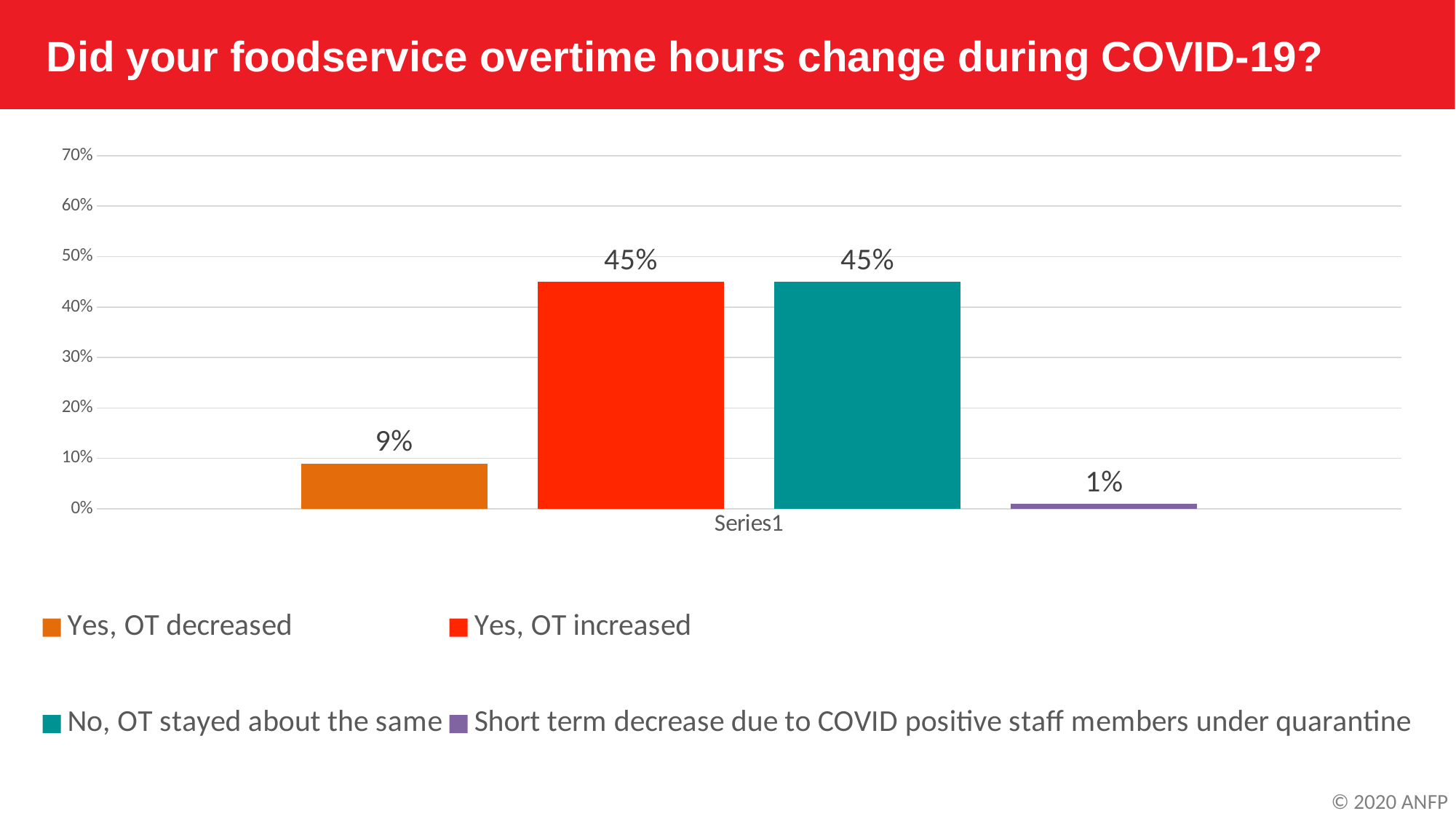
What colour is the bar for 'No, OT stayed about the same'? Teal Which is larger: the percentage for 'Yes, OT decreased' or for 'Short term decrease due to COVID positive staff members under quarantine'? Yes, OT decreased What percentage of respondents said their OT increased? 45% What percentage of respondents reported a short term decrease due to COVID positive staff members under quarantine? 1% What percentage of respondents said their OT decreased? 9% What kind of chart is shown on the slide? Bar chart What is the difference between the percentage for 'Yes, OT increased' and 'Yes, OT decreased'? 36% How many series does the legend list? 4 Is the value for 'Yes, OT increased' greater or less than 40%? greater Which response has the lowest percentage? Short term decrease due to COVID positive staff members under quarantine What is the title of the chart? Did your foodservice overtime hours change during COVID-19? What percentage of respondents said OT stayed about the same? 45%